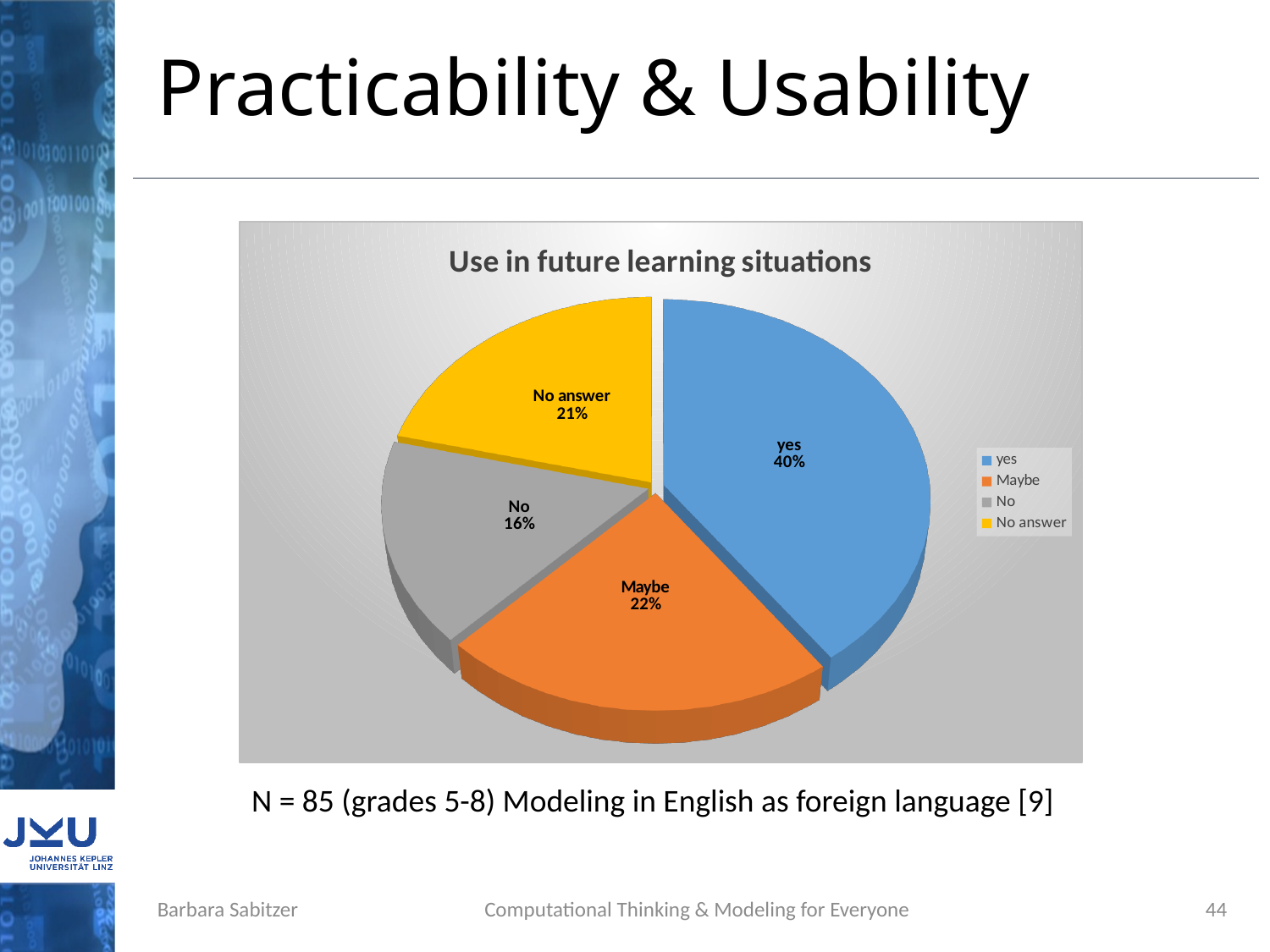
What kind of chart is shown on the slide? pie chart What percentage of the pie is the "No answer" slice? 21% How many slices does the pie chart have? 4 How many entries does the legend list? 4 Which category has the largest share of the pie? yes Which category has the smallest share of the pie? No What percentage of the pie is the "Maybe" slice? 22% What percentage of the pie is the "yes" slice? 40% What is the difference in percentage points between the "yes" slice and the "No" slice? 24 What percentage of the pie is the "No" slice? 16% What is the title of the chart? Use in future learning situations Which slice is larger, "Maybe" or "No answer"? Maybe